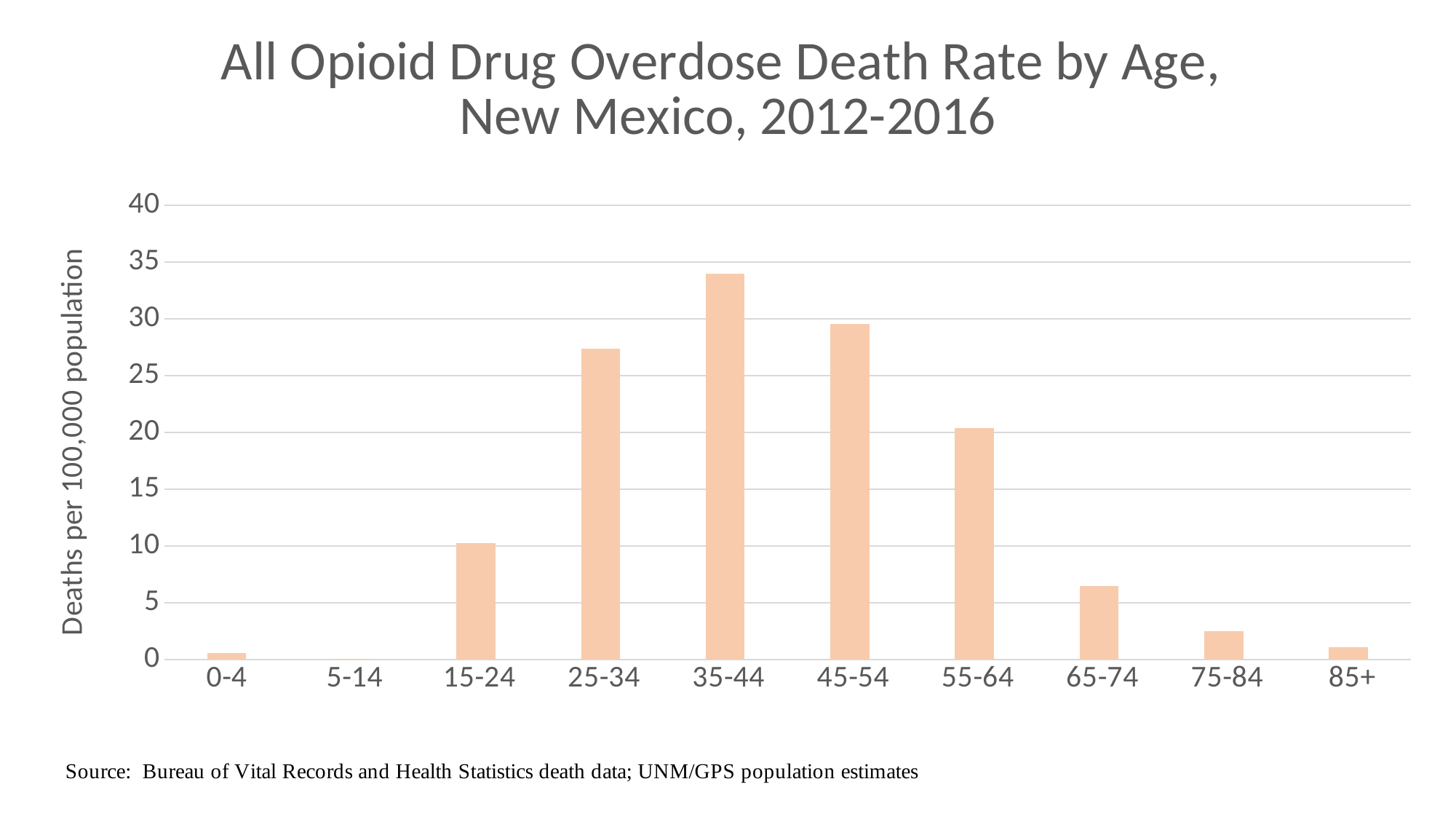
Is the value for the 35-44 age group greater or less than 30? greater What type of chart is shown on the slide? bar chart Is the value for the 25-34 age group greater or less than 25? greater Is the value for the 55-64 age group greater or less than 25? less Which age group has the lowest opioid drug overdose death rate? 5-14 Which age group has a higher death rate, 75-84 or 85+? 75-84 What is the label of the y axis? Deaths per 100,000 population Which age group has a higher death rate, 45-54 or 55-64? 45-54 Which age group has the highest opioid drug overdose death rate? 35-44 How many age groups are shown on the x axis? 10